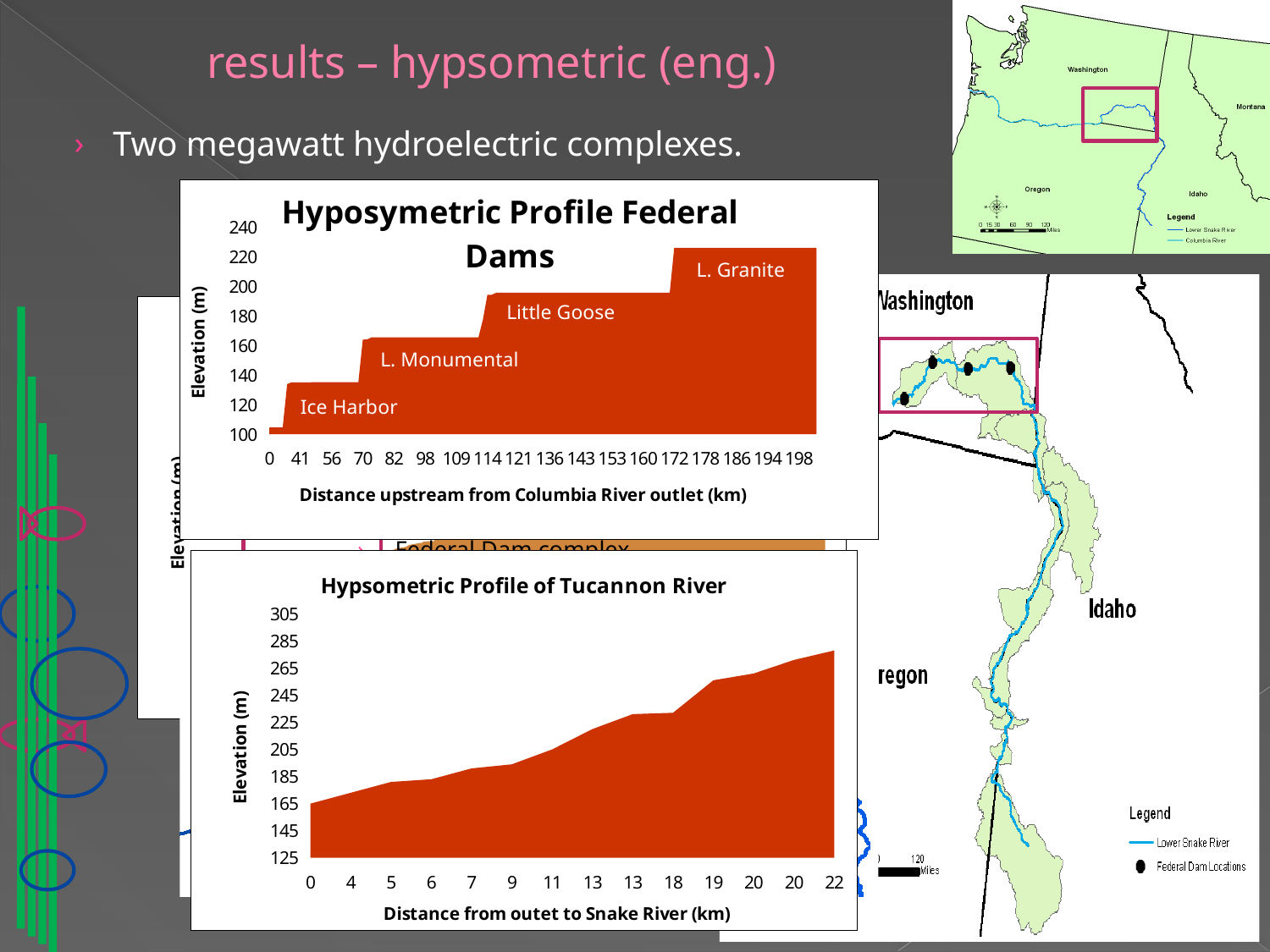
In the 'Hypsometric Profile of Tucannon River' chart, is the elevation at 0 km greater or less than 185? less In the 'Hypsometric Profile of Tucannon River' chart, is the elevation at 22 km greater or less than 265? greater In the 'Hyposymetric Profile Federal Dams' chart, is the elevation at L. Granite greater or less than 200? greater What kind of chart is the 'Hyposymetric Profile Federal Dams' chart? area chart In the 'Hyposymetric Profile Federal Dams' chart, which labeled dam has the lowest elevation? Ice Harbor In the 'Hypsometric Profile of Tucannon River' chart, does elevation rise or fall as distance from the outlet increases? rises What is the x-axis title of the 'Hyposymetric Profile Federal Dams' chart? Distance upstream from Columbia River outlet (km) In the 'Hyposymetric Profile Federal Dams' chart, which labeled dam has the highest elevation? L. Granite In the 'Hyposymetric Profile Federal Dams' chart, does elevation rise or fall as distance upstream increases? rises In the 'Hyposymetric Profile Federal Dams' chart, which is higher in elevation, Little Goose or L. Monumental? Little Goose